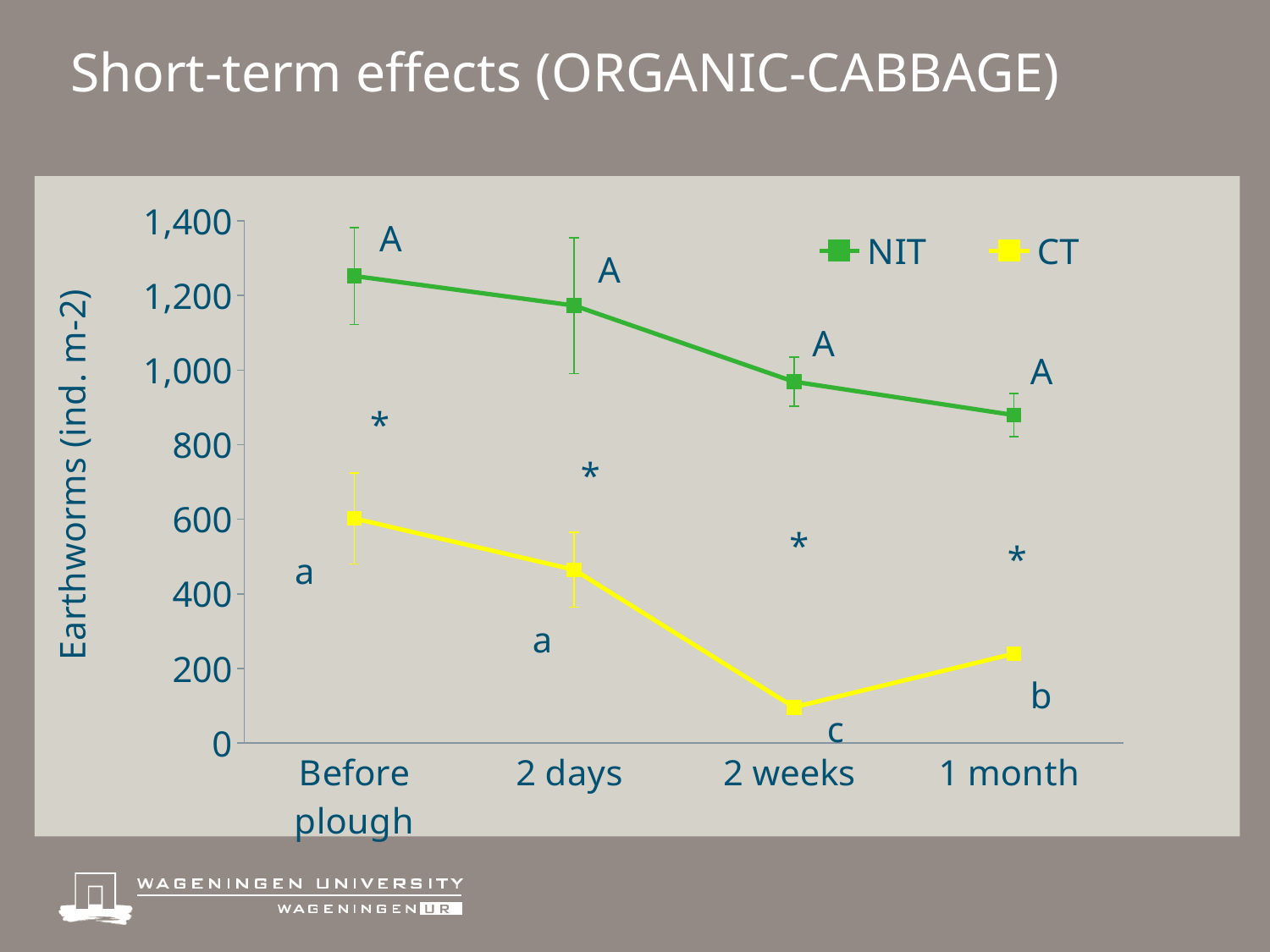
How many time points are plotted along the x axis? 4 What kind of chart is shown on the slide? line chart At which time point is the CT series highest? Before plough At which time point is the NIT series lowest? 1 month At which time point is the CT series lowest? 2 weeks Do the NIT values rise or fall from Before plough to 1 month? fall How many series does the legend list? 2 Is the CT value at 2 weeks greater or less than 200? less What is the label of the y axis? Earthworms (ind. m-2) At which time point is the NIT series highest? Before plough Which series has the larger value at 2 weeks, NIT or CT? NIT Is the NIT value at 1 month greater or less than 1,000? less